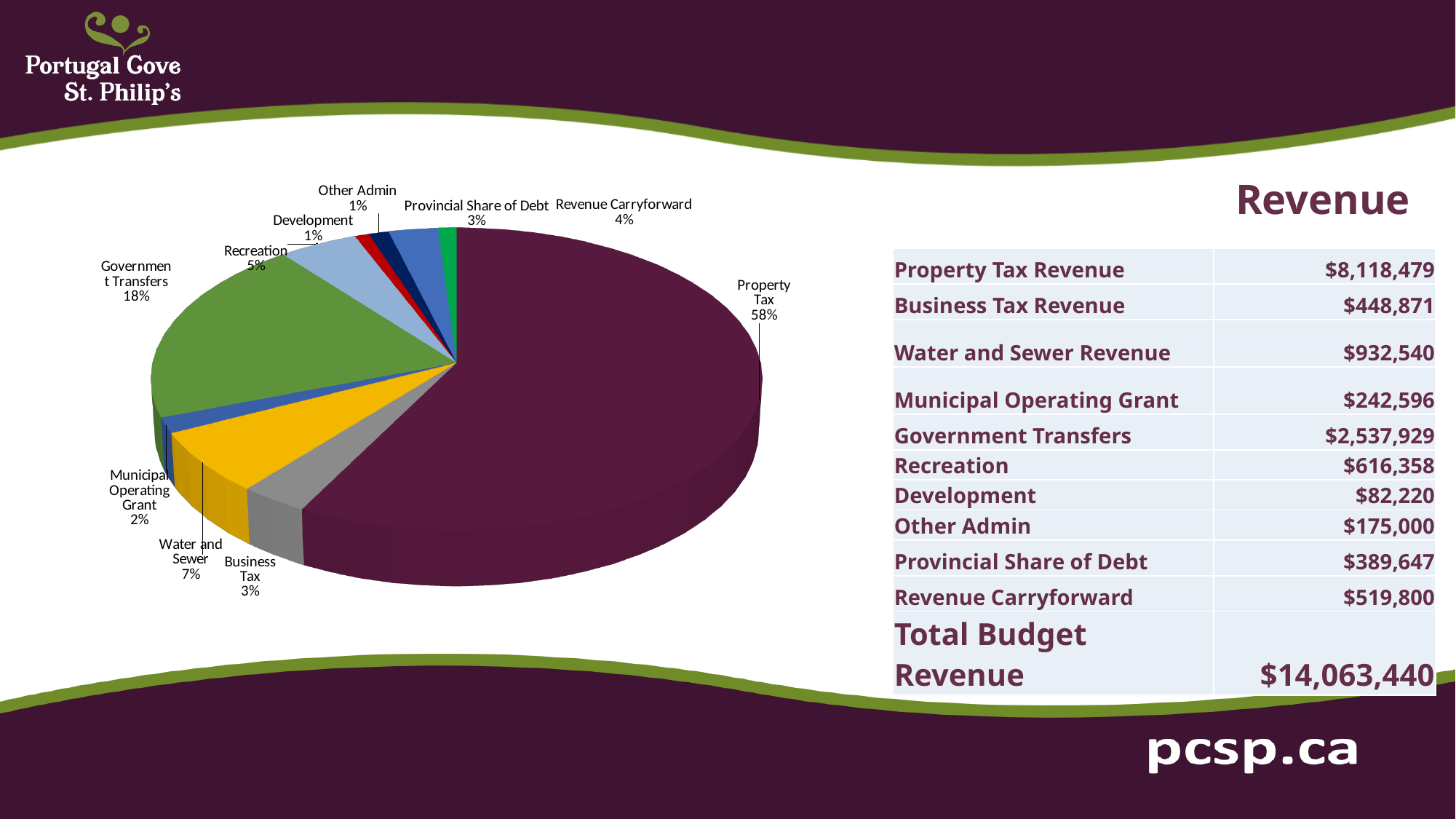
What percentage is shown for Recreation in the pie chart? 5% What share of the pie does Property Tax represent? 58% What percentage is shown for Revenue Carryforward in the pie chart? 4% What is the difference in percentage points between Water and Sewer and Business Tax in the pie chart? 4 What share of the pie does Government Transfers represent? 18% What kind of chart is shown on the slide? pie chart Which category has the largest slice of the pie? Property Tax What colour is the Property Tax slice in the pie chart? dark purple Which is larger in the pie chart, Government Transfers or Water and Sewer? Government Transfers What percentage is shown for Water and Sewer in the pie chart? 7% How many slices does the pie chart have? 10 What is the difference in percentage points between Property Tax and Government Transfers in the pie chart? 40